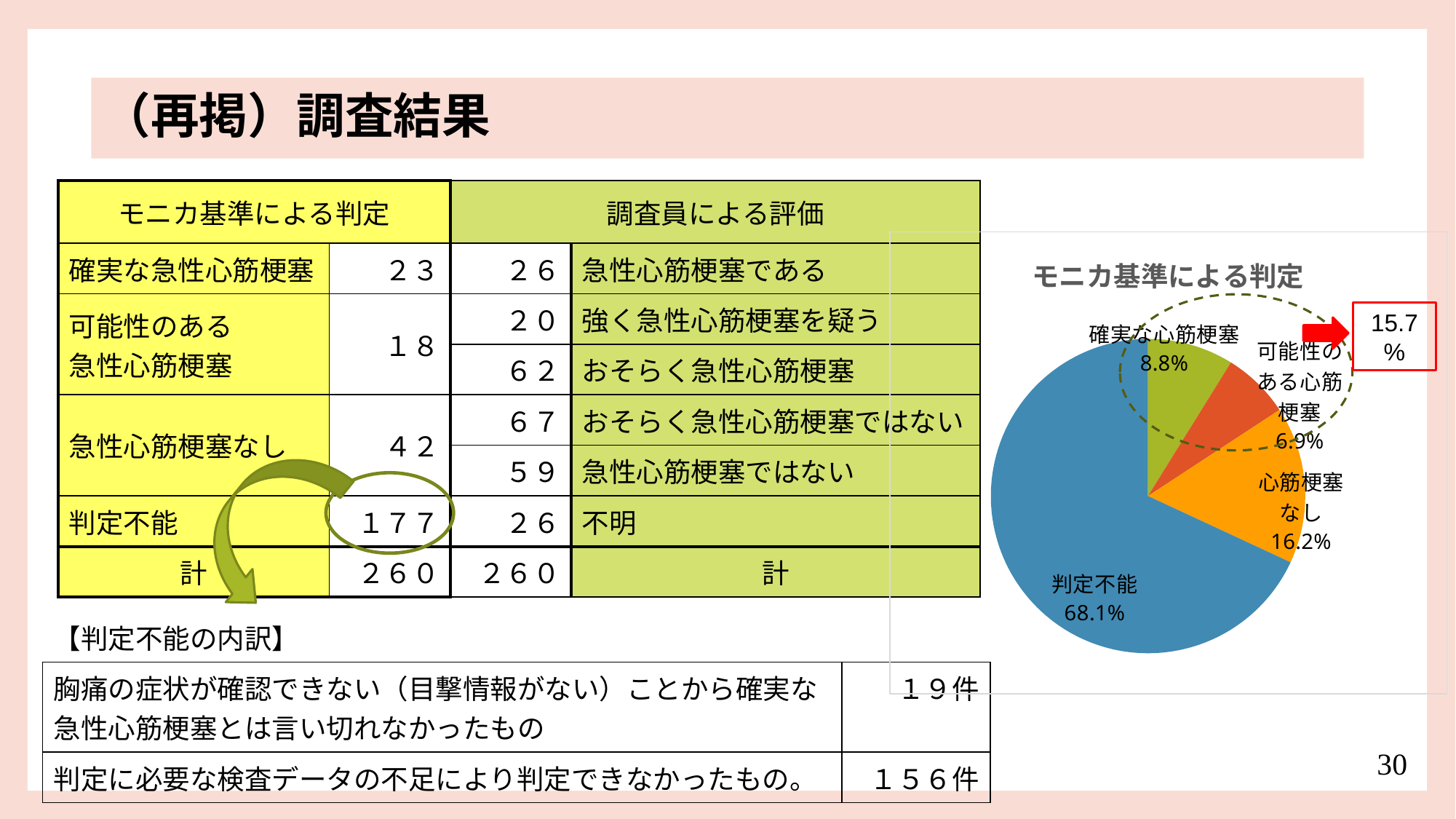
How many slices does the pie chart have? 4 In the pie chart, which is larger: 確実な心筋梗塞 or 心筋梗塞なし? 心筋梗塞なし What is the title of the pie chart? モニカ基準による判定 What kind of chart is shown on the right of the slide? pie chart What is the difference in percentage points between 判定不能 and 心筋梗塞なし in the pie chart? 51.9 What share of the pie chart is 確実な心筋梗塞? 8.8% What combined percentage is shown in the red callout box next to the pie chart? 15.7% Which slice of the pie chart is the largest? 判定不能 What share of the pie chart is 心筋梗塞なし? 16.2% Which slice of the pie chart is the smallest? 可能性のある心筋梗塞 What share of the pie chart is 可能性のある心筋梗塞? 6.9%